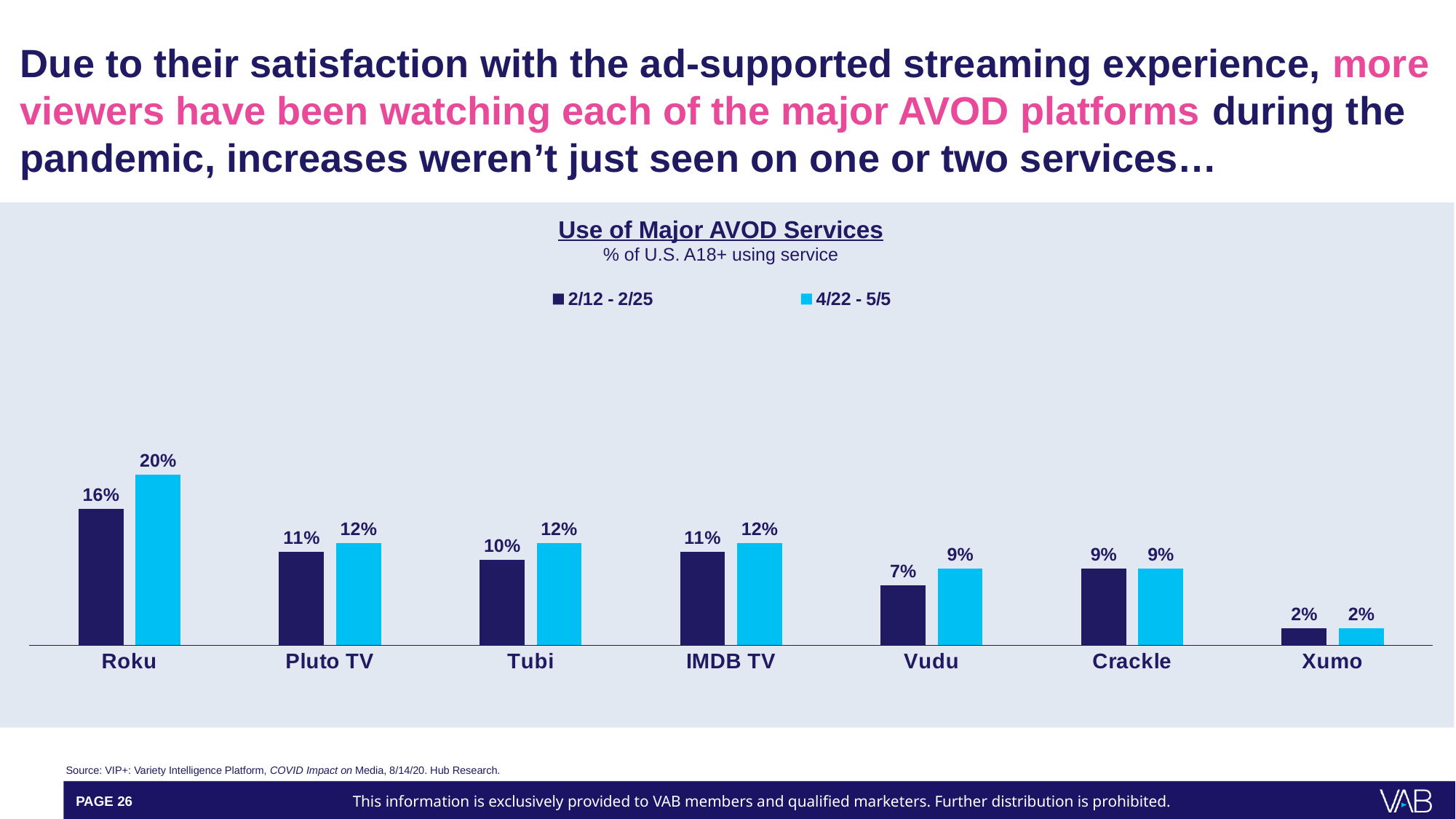
How many services are shown on the chart? 7 What percentage of U.S. A18+ used Roku in the 4/22 - 5/5 period? 20% By how many percentage points did Roku's usage increase from 2/12 - 2/25 to 4/22 - 5/5? 4 percentage points Which service had the highest usage in the 4/22 - 5/5 period? Roku What is the difference between Pluto TV and Vudu in the 4/22 - 5/5 period? 3 percentage points Which was larger in the 2/12 - 2/25 period: Roku or Pluto TV? Roku What was the value for Tubi in the 2/12 - 2/25 period? 10% Which service had the lowest usage in the 2/12 - 2/25 period? Xumo What was the value for Vudu in the 2/12 - 2/25 period? 7% What type of chart is shown on the slide? Bar chart How many series does the legend list? 2 What is the title of the chart? Use of Major AVOD Services